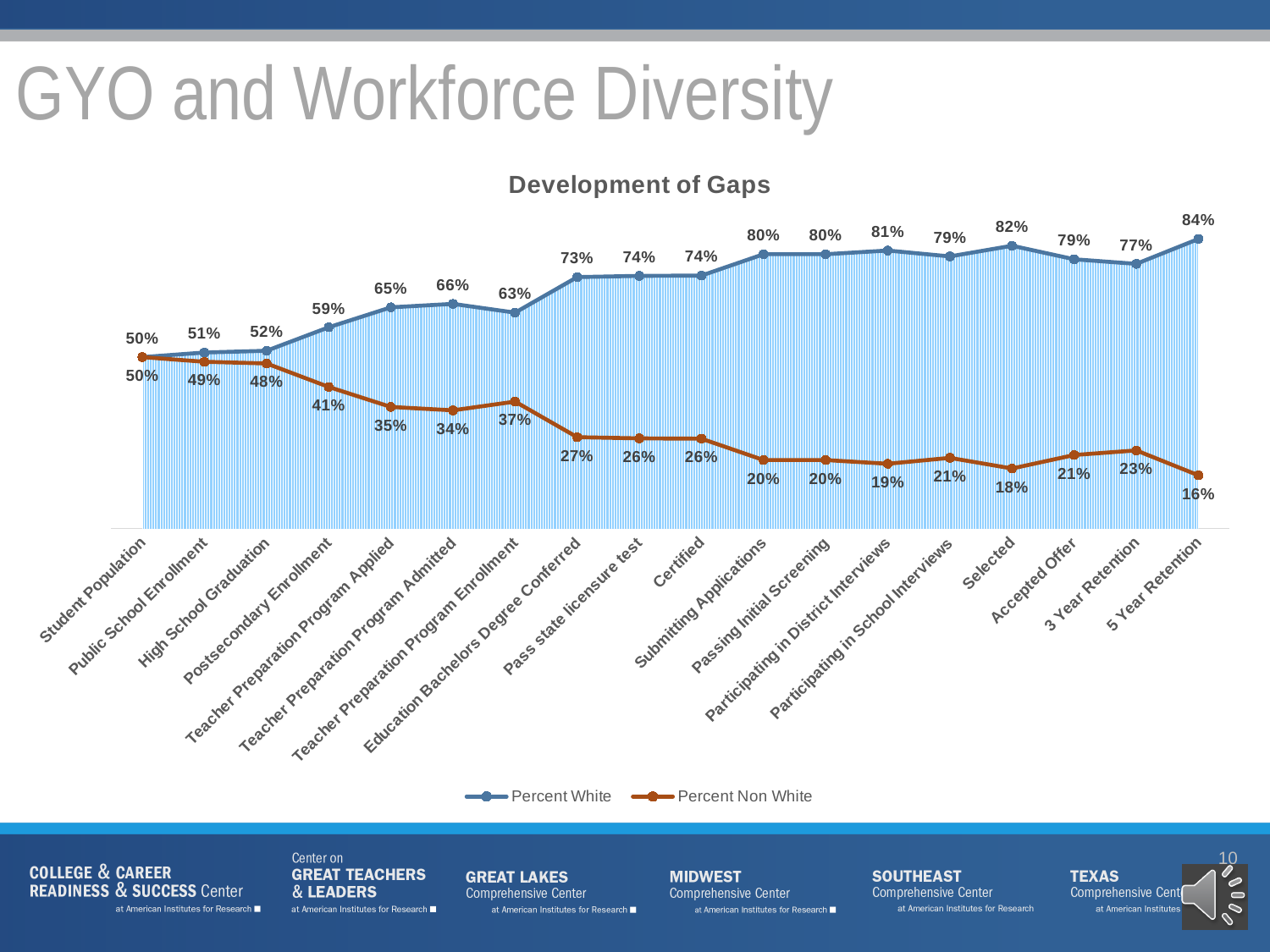
What is the difference between Percent White and Percent Non White at 5 Year Retention? 68 percentage points Does the Percent Non White series generally rise or fall from Student Population to 5 Year Retention? Fall What is the difference between Percent White and Percent Non White at Postsecondary Enrollment? 18 percentage points Which category has the lowest Percent Non White value? 5 Year Retention What is the Percent White value for Certified? 74% What is the Percent Non White value for Selected? 18% How many categories are plotted along the x axis? 18 How many series does the legend list? 2 Which category has the highest Percent White value? 5 Year Retention What is the Percent Non White value for Teacher Preparation Program Admitted? 34% What type of chart is shown on the slide? Line chart Which is larger: Percent Non White at 3 Year Retention or Percent Non White at Selected? 3 Year Retention